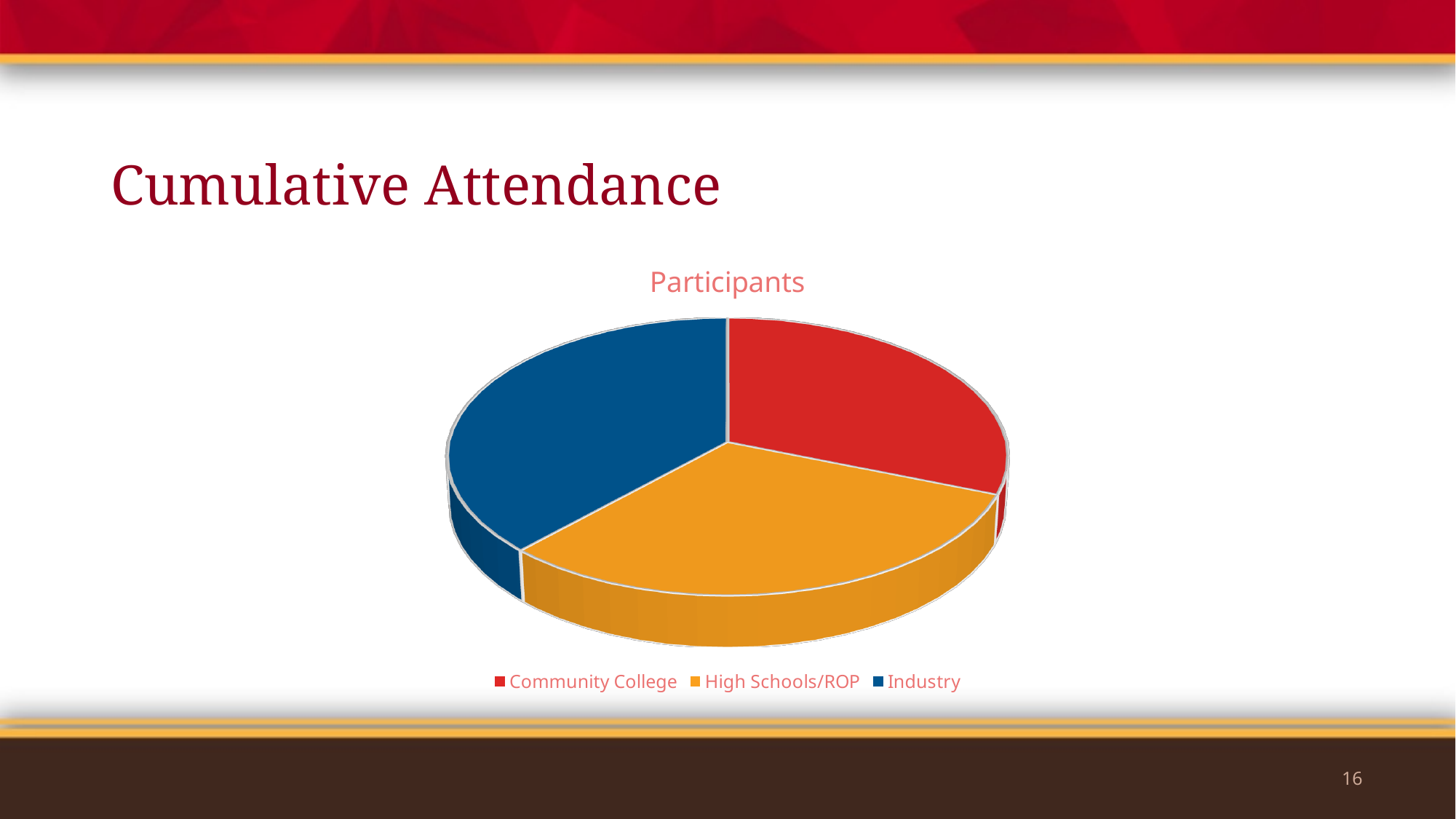
How many entries does the chart legend list? 3 Which slice is larger, High Schools/ROP or Industry? Industry Which category has the largest slice of the pie? Industry Which category is shown in red in the pie chart? Community College What is the title of the chart? Participants How many slices does the pie chart have? 3 What colour is the Industry slice? Blue What kind of chart is shown on the slide? Pie chart